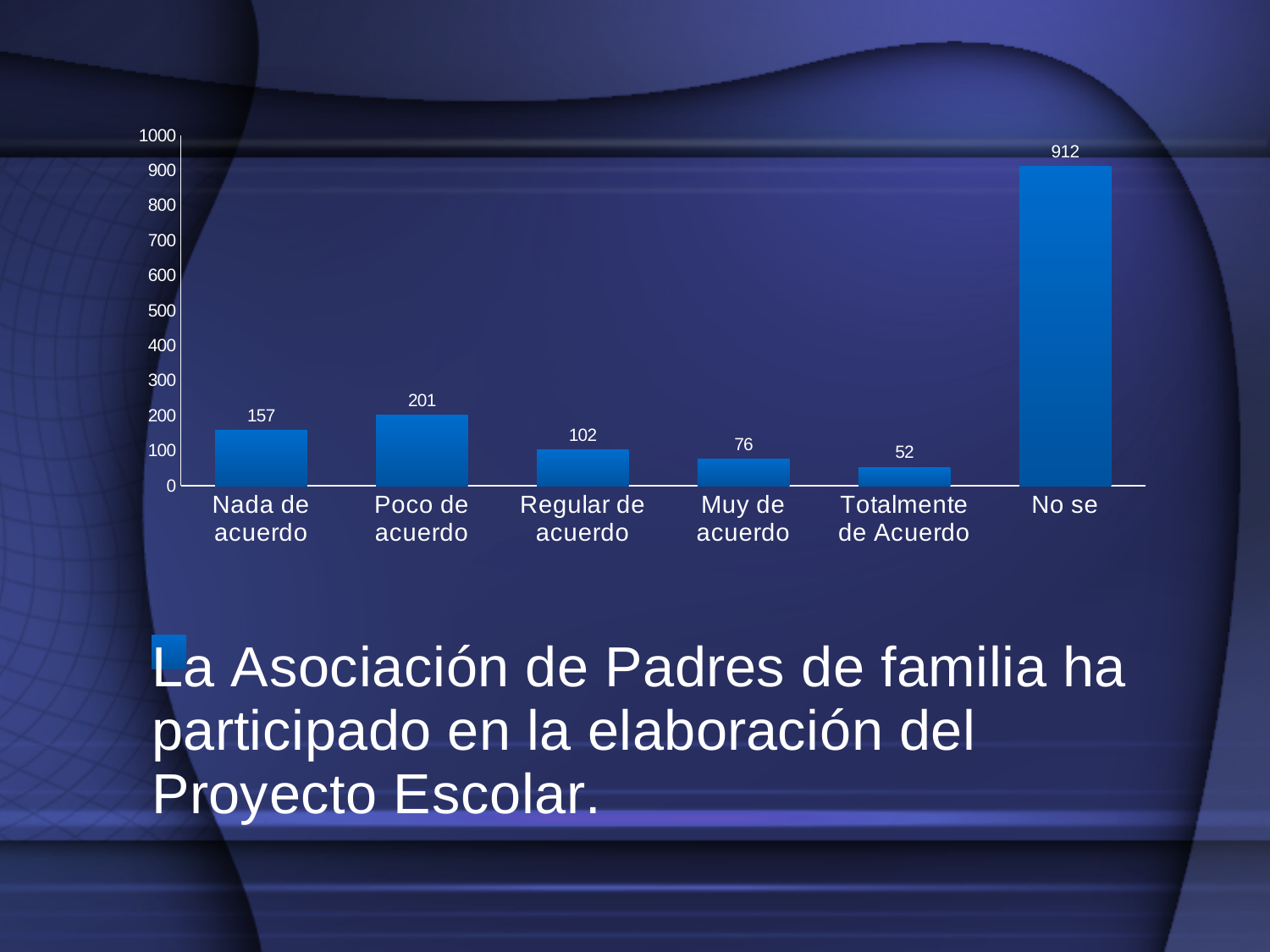
What kind of chart is shown on the slide? bar chart What is the difference between the values for "Poco de acuerdo" and "Nada de acuerdo"? 44 Which category has the lowest value? Totalmente de Acuerdo What is the difference between the values for "No se" and "Totalmente de Acuerdo"? 860 What is the value for "No se"? 912 What is the value for "Totalmente de Acuerdo"? 52 Which is larger, the value for "Regular de acuerdo" or the value for "Muy de acuerdo"? Regular de acuerdo What is the value for "Poco de acuerdo"? 201 What is the value for "Muy de acuerdo"? 76 Which category has the highest value? No se Is the value for "No se" greater or less than 900? greater How many categories are shown on the x axis? 6